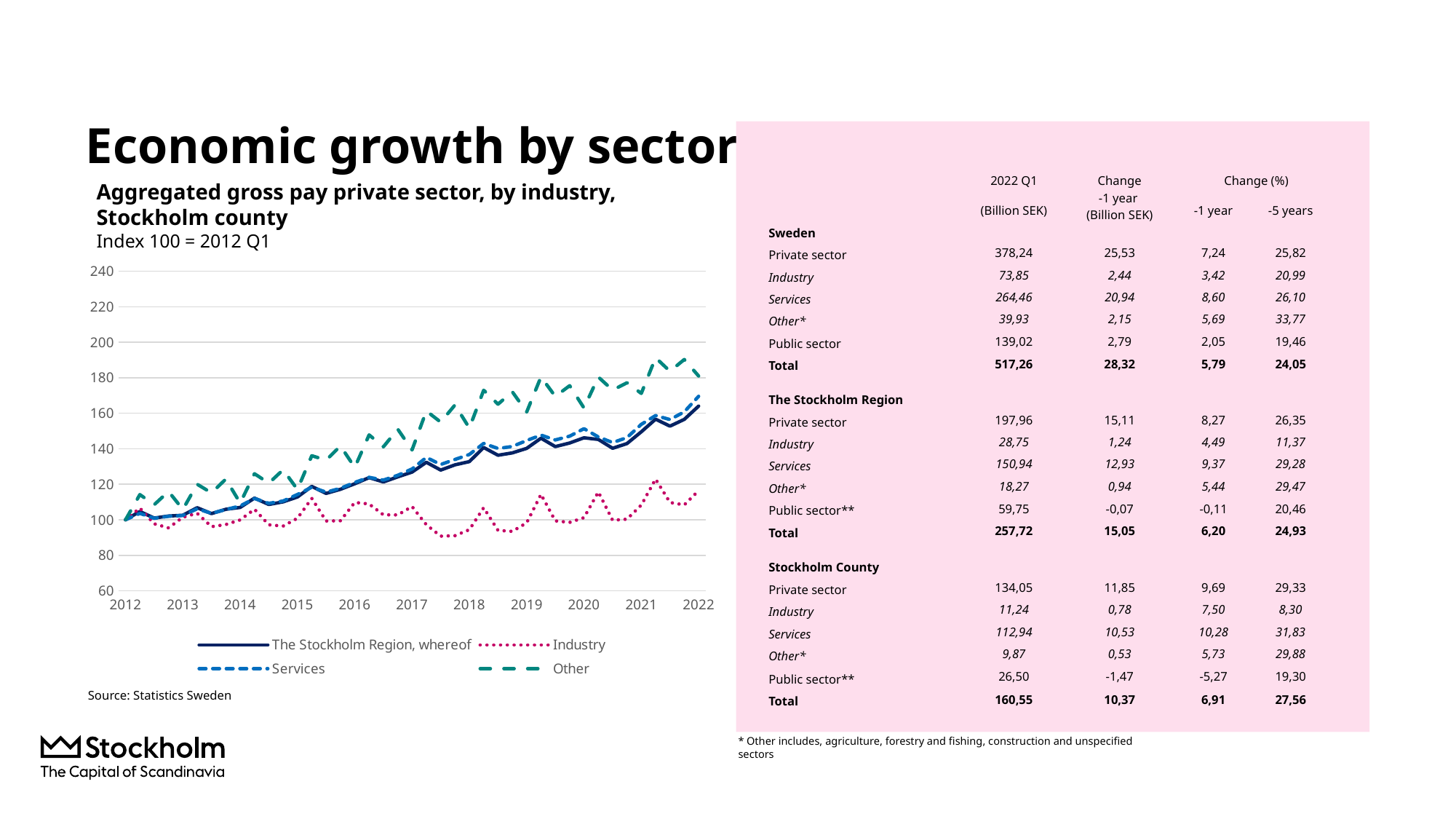
What is the index base stated below the chart title? Index 100 = 2012 Q1 Which series has the lowest index value at the end of the chart in 2022? Industry In 2020, which series has the larger index value, Other or Industry? Other Does the Services series rise or fall overall from 2012 to 2022? Rise How many series does the chart legend list? 4 Is the value for Industry at the end of 2022 greater or less than 140? less Which series has the highest index value at the end of the chart in 2022? Other Is the value for Other at the end of 2022 greater or less than 160? greater Is the value for The Stockholm Region, whereof at the end of 2022 greater or less than 140? greater How many year labels are shown on the x axis of the chart? 11 What kind of chart is shown on the slide? Line chart What is the source given for the chart? Statistics Sweden